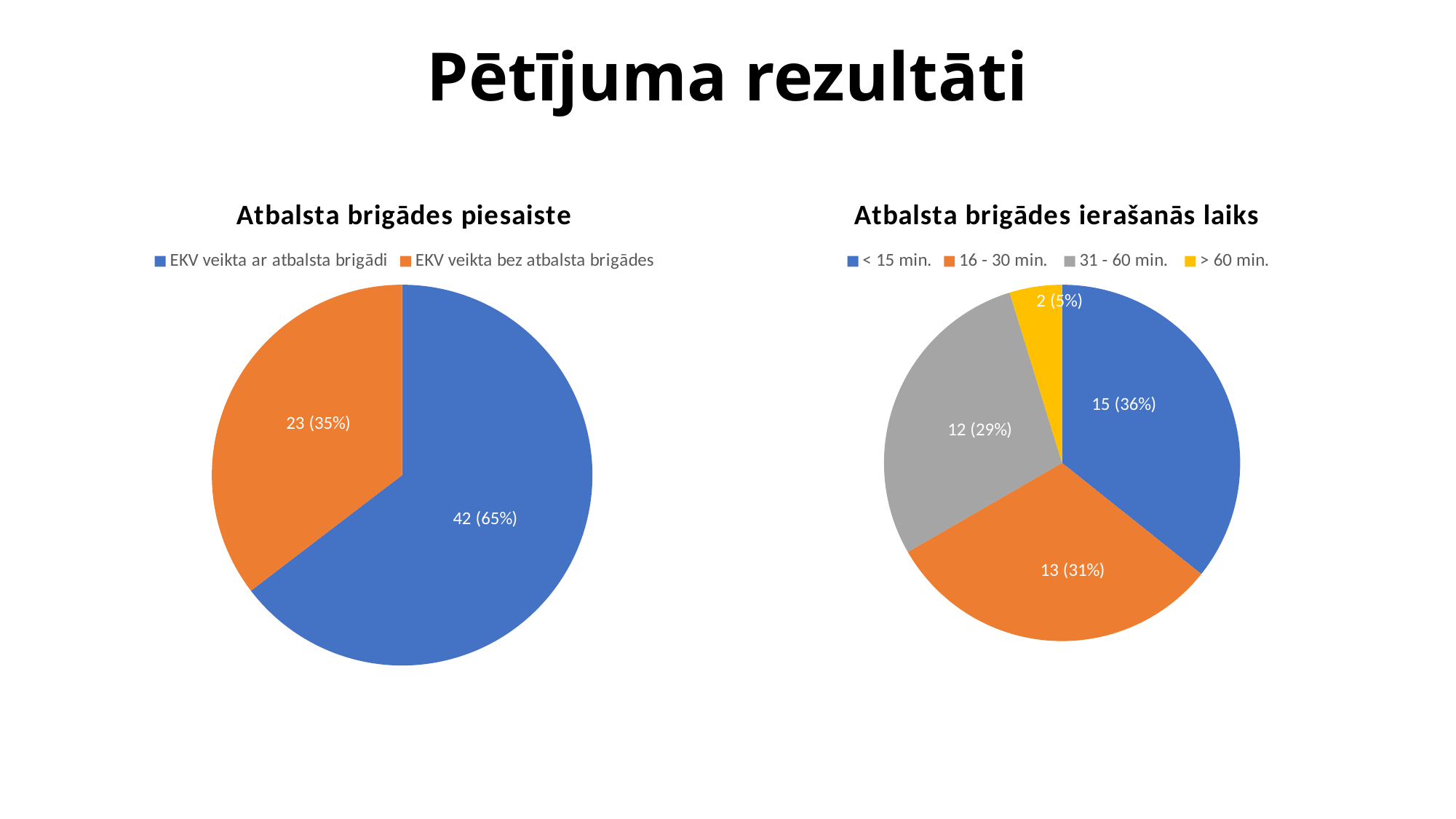
In the 'Atbalsta brigādes ierašanās laiks' chart, what share of the pie does '16 - 30 min.' take? 31% In the 'Atbalsta brigādes ierašanās laiks' chart, which colour represents '> 60 min.'? Yellow In the 'Atbalsta brigādes ierašanās laiks' chart, what is the value for '< 15 min.'? 15 (36%) In the 'Atbalsta brigādes ierašanās laiks' chart, which category has the largest slice? < 15 min. In the 'Atbalsta brigādes ierašanās laiks' chart, how many categories does the legend list? 4 In the 'Atbalsta brigādes piesaiste' chart, what is the value for 'EKV veikta bez atbalsta brigādes'? 23 (35%) In the 'Atbalsta brigādes ierašanās laiks' chart, which category has the smallest slice? > 60 min. What kind of chart is 'Atbalsta brigādes piesaiste'? Pie chart In the 'Atbalsta brigādes piesaiste' chart, what is the value for 'EKV veikta ar atbalsta brigādi'? 42 (65%) In the 'Atbalsta brigādes ierašanās laiks' chart, what is the value for '31 - 60 min.'? 12 (29%) In the 'Atbalsta brigādes piesaiste' chart, what share of the pie does 'EKV veikta bez atbalsta brigādes' take? 35% In the 'Atbalsta brigādes piesaiste' chart, what is the difference between the two slice counts? 19